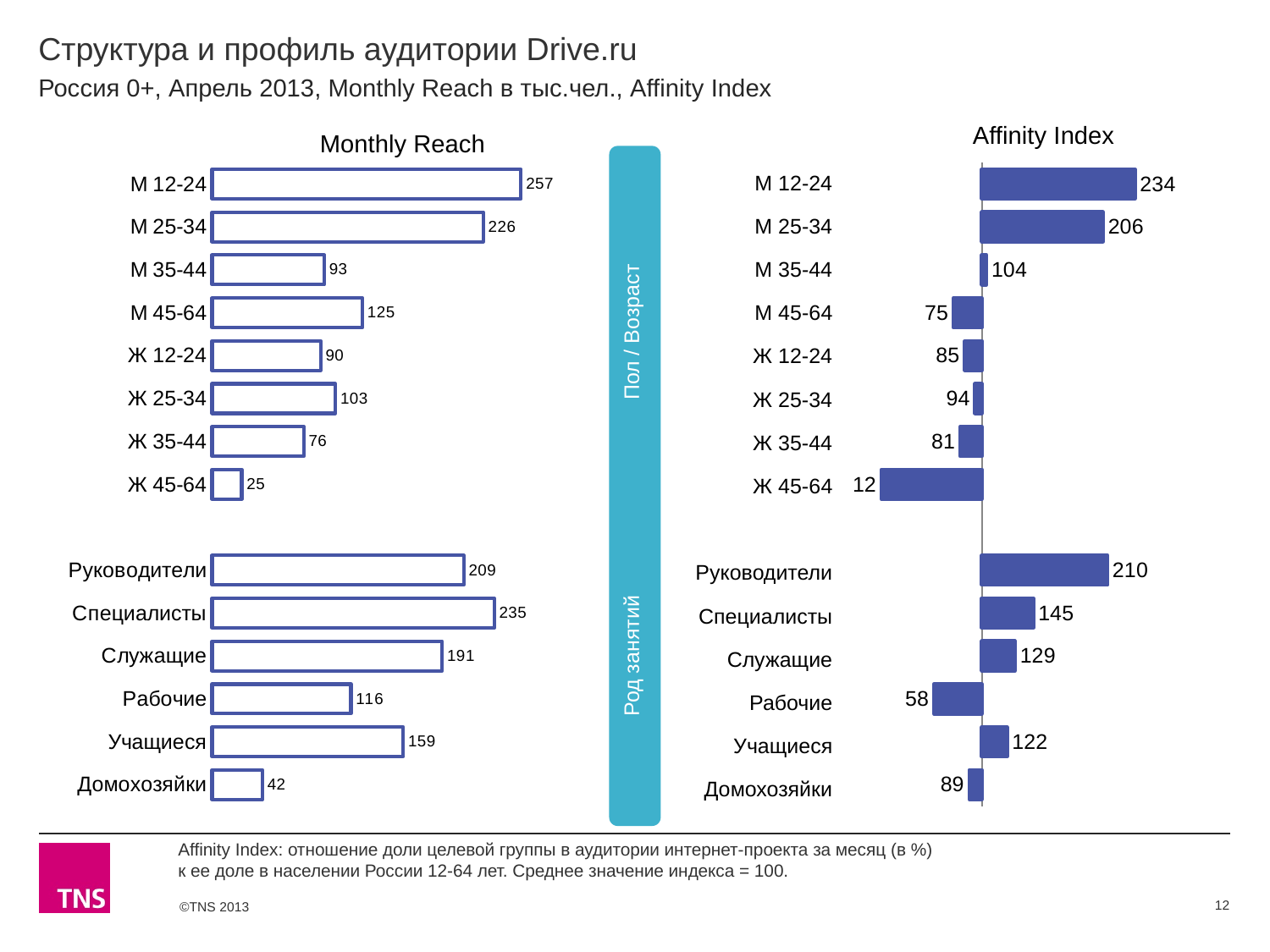
What is the title of the chart on the left side of the slide? Monthly Reach In the Monthly Reach chart, what is the difference between М 25-34 and М 35-44? 133 In the Affinity Index chart, what is the value for Ж 45-64? 12 In the Affinity Index chart, which is larger: Служащие or Учащиеся? Служащие In the Affinity Index chart, which category has the highest value? М 12-24 In the Monthly Reach chart, what is the value for М 12-24? 257 In the Monthly Reach chart, what is the difference between Специалисты and Руководители? 26 In the Monthly Reach chart, how many categories are plotted? 14 In the Affinity Index chart, which category has the lowest value among the occupation groups (Род занятий)? Рабочие What type of chart is the Affinity Index chart? Bar chart In the Affinity Index chart, what is the value for Руководители? 210 In the Monthly Reach chart, which category has the lowest value? Ж 45-64